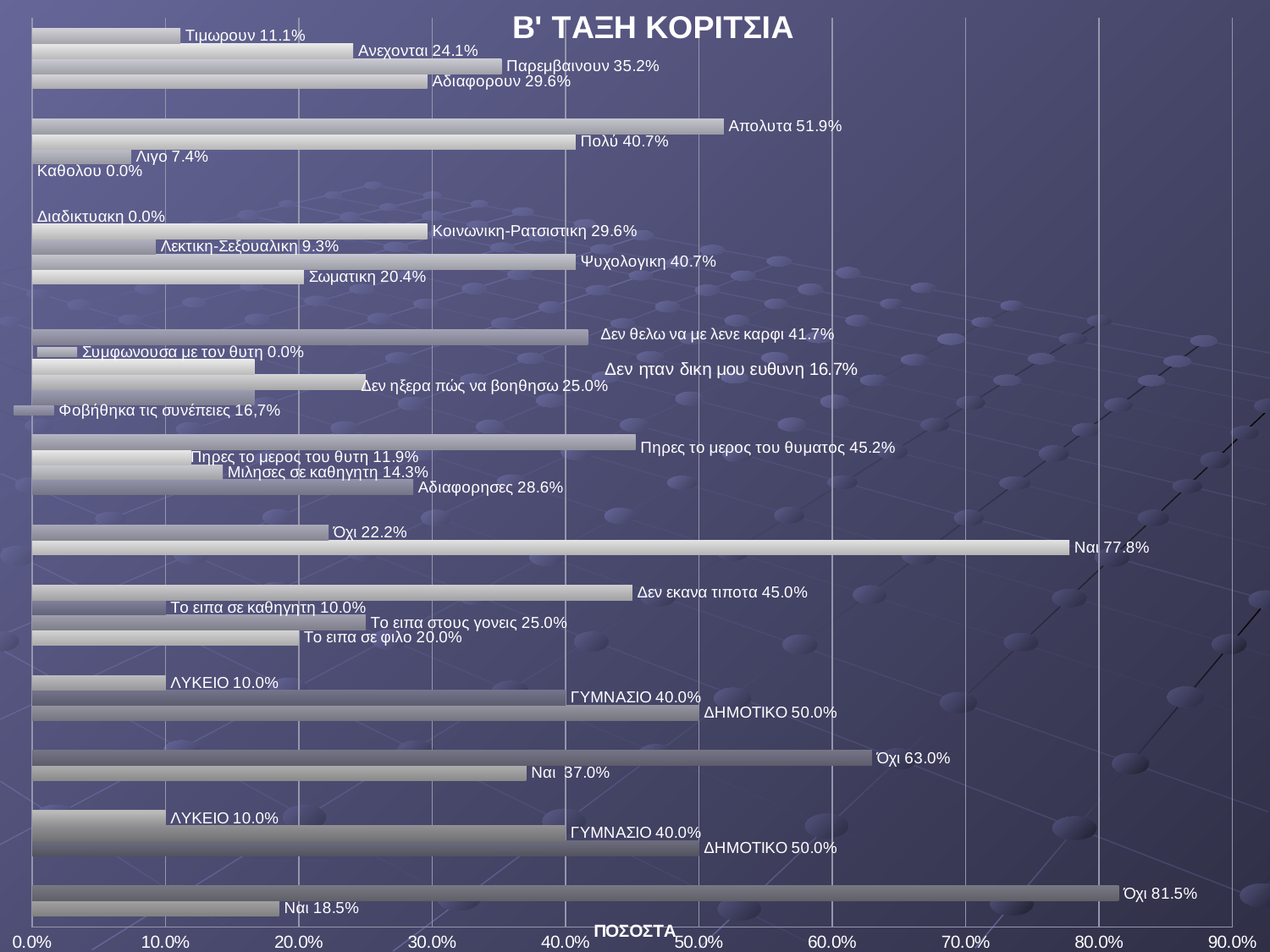
What is the title of the chart? Β' ΤΑΞΗ ΚΟΡΙΤΣΙΑ What is the value for Δεν θελω να με λενε καρφι? 41.7% Which is larger, the value for Ανεχονται or the value for Παρεμβαινουν? Παρεμβαινουν What kind of chart is shown on the slide? bar chart What is the value for Κοινωνικη-Ρατσιστικη? 29.6% Which bar has the highest value in the whole chart? Όχι 81.5% What is the value for Απολυτα? 51.9% What is the value for Παρεμβαινουν? 35.2% What is the label of the horizontal axis? ΠΟΣΟΣΤΑ What is the value for Πηρες το μερος του θυματος? 45.2% What is the difference between the values for Απολυτα and Πολύ? 11.2% Is the value for Δεν εκανα τιποτα greater or less than 40.0%? greater